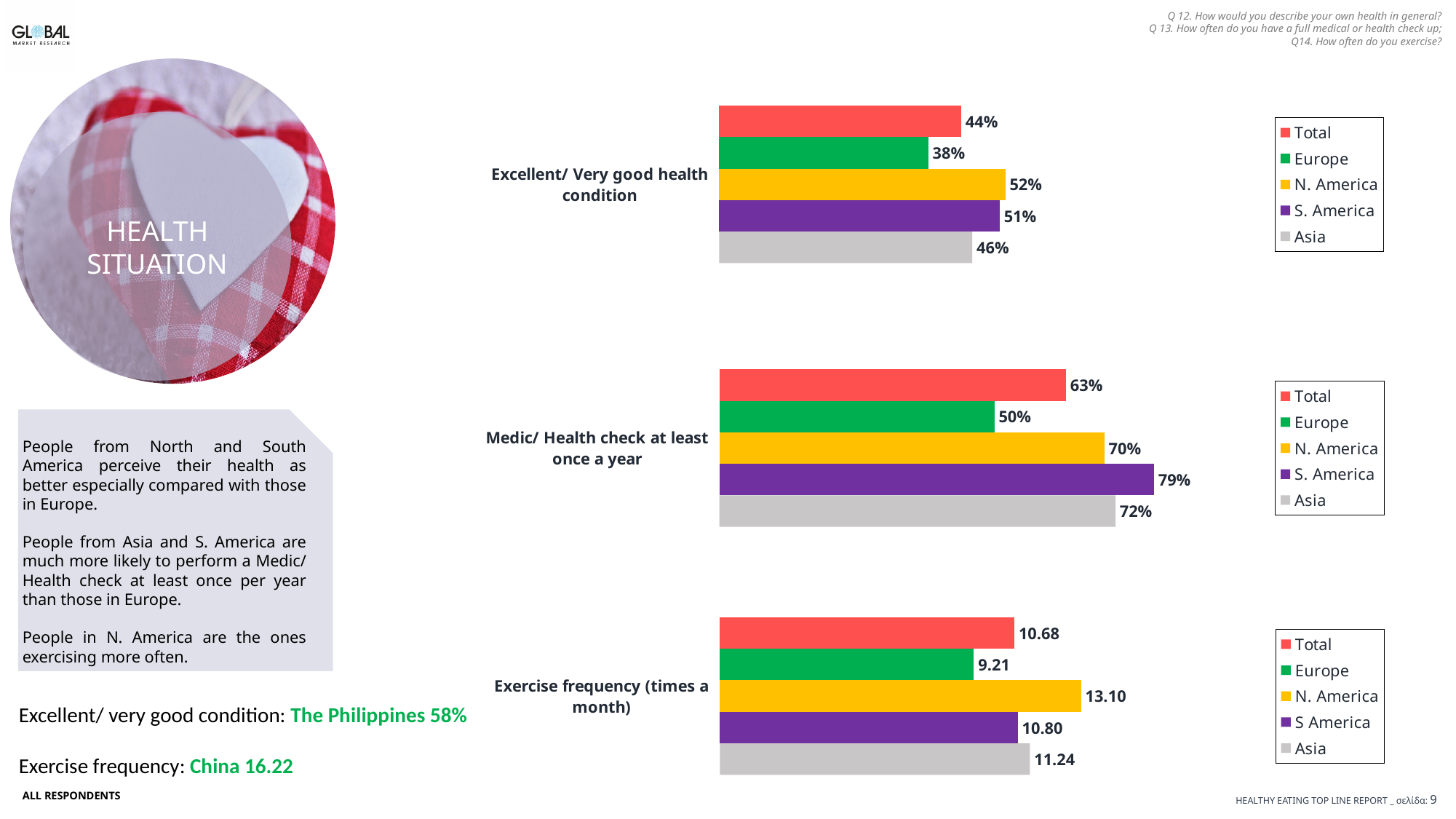
In the 'Medic/ Health check at least once a year' chart, which region has the lowest value? Europe In the 'Exercise frequency (times a month)' chart, which region has the lowest value? Europe In the 'Medic/ Health check at least once a year' chart, what is the value for S. America? 79% In the 'Excellent/ Very good health condition' chart, which region has the highest value? N. America What type of chart is used for 'Exercise frequency (times a month)'? Bar chart In the 'Medic/ Health check at least once a year' chart, what is the difference between S. America and Total? 16% In the 'Medic/ Health check at least once a year' chart, which is larger, the value for Asia or the value for N. America? Asia In the 'Exercise frequency (times a month)' chart, what is the value for N. America? 13.10 In the 'Excellent/ Very good health condition' chart, what is the value for Europe? 38% How many series does the legend of the 'Excellent/ Very good health condition' chart list? 5 In the 'Exercise frequency (times a month)' chart, what is the value for Asia? 11.24 In the 'Excellent/ Very good health condition' chart, what is the difference between N. America and Europe? 14%